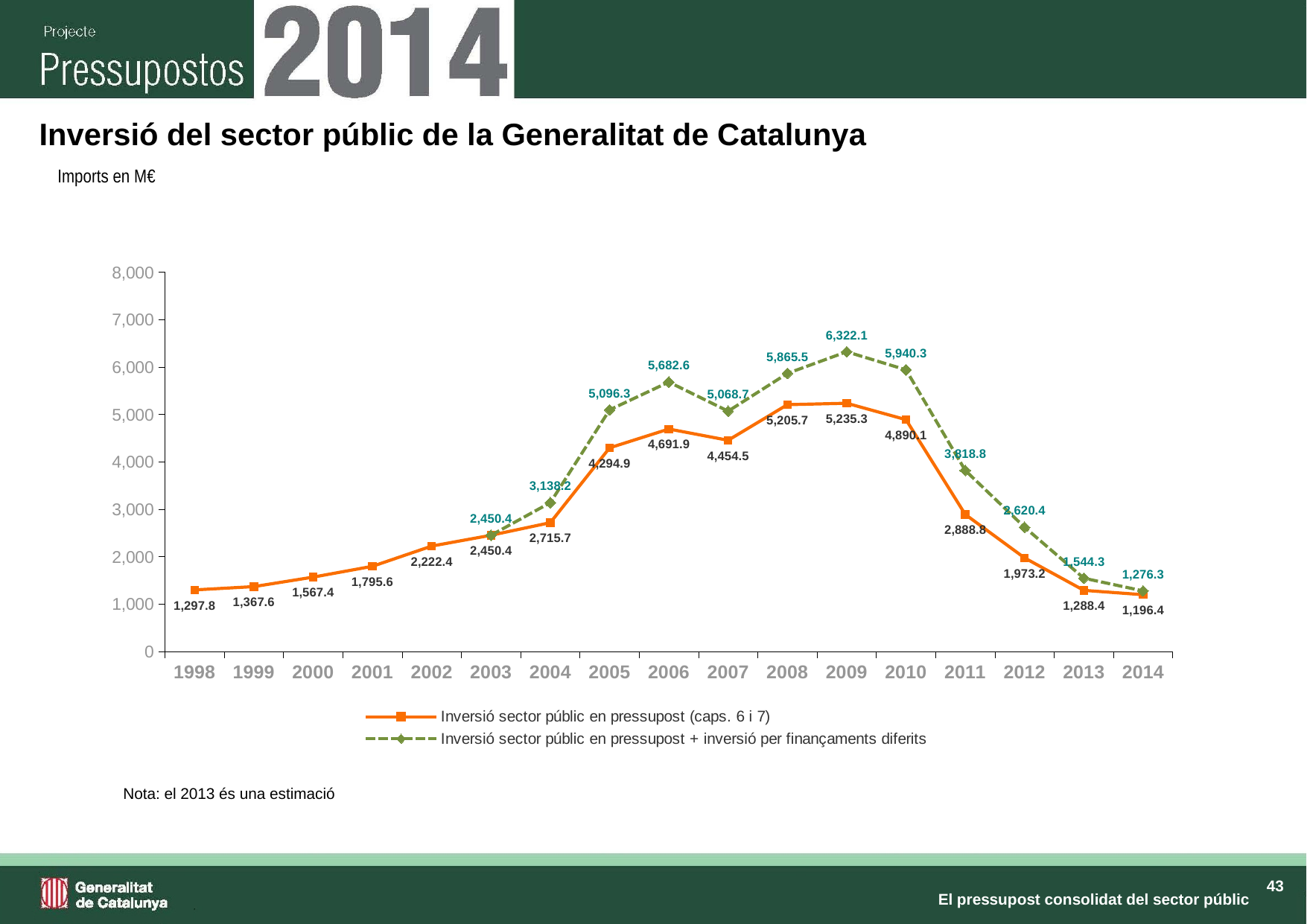
What type of chart is shown on the slide? Line chart In which year is 'Inversió sector públic en pressupost (caps. 6 i 7)' at its lowest? 2014 In which year does 'Inversió sector públic en pressupost + inversió per finançaments diferits' reach its highest value? 2009 How many series does the legend list? 2 Does 'Inversió sector públic en pressupost (caps. 6 i 7)' rise or fall from 2010 to 2014? Fall What unit is stated for the amounts in the chart? M€ What is the value of 'Inversió sector públic en pressupost (caps. 6 i 7)' in 1998? 1,297.8 What is the difference between the two series in 2009? 1,086.8 Which is larger for 'Inversió sector públic en pressupost (caps. 6 i 7)': the value in 2006 or in 2007? 2006 How many years are plotted along the x axis? 17 What is the value of 'Inversió sector públic en pressupost (caps. 6 i 7)' in 2009? 5,235.3 What is the value of 'Inversió sector públic en pressupost + inversió per finançaments diferits' in 2009? 6,322.1